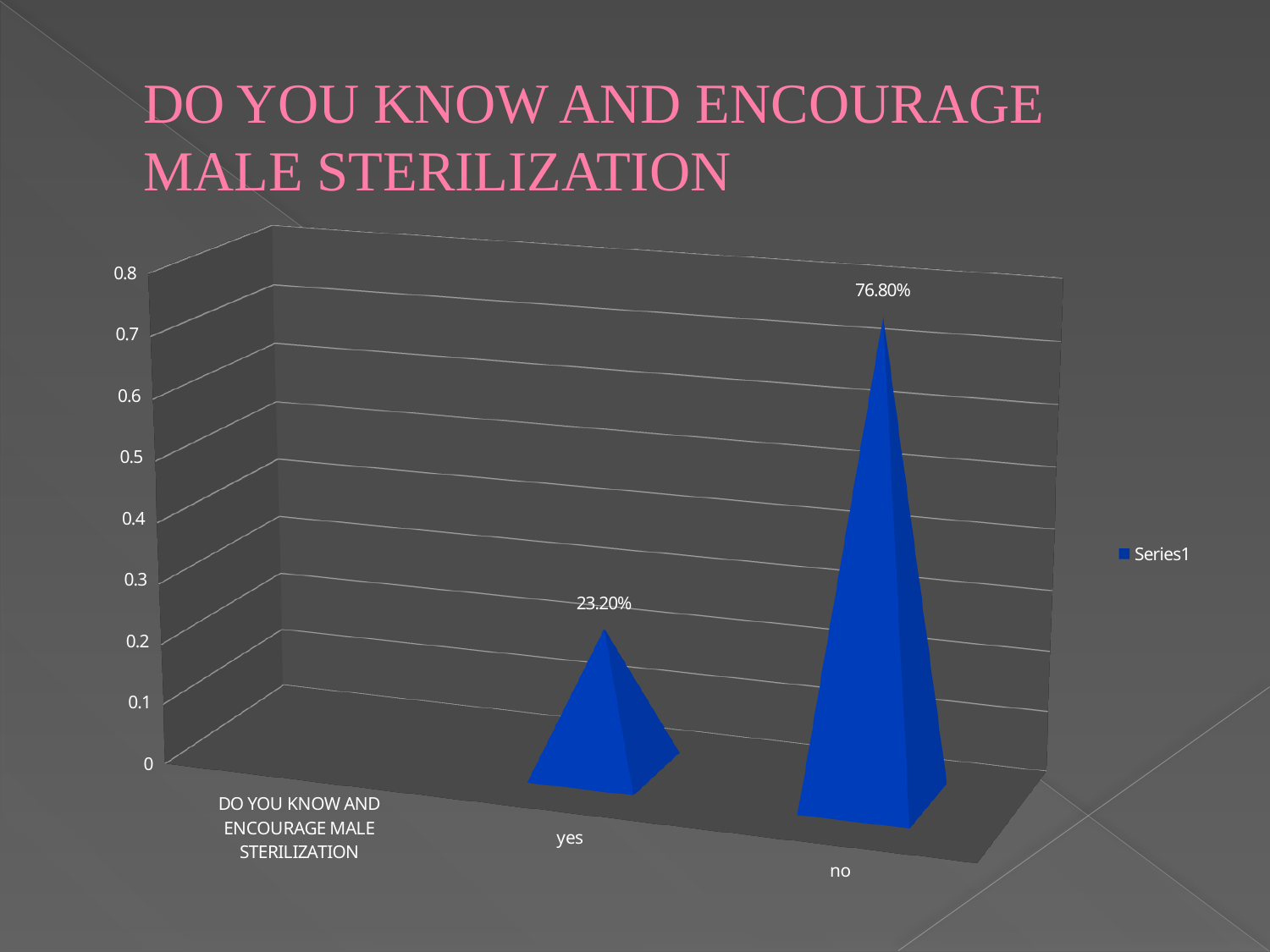
What is the value for "no"? 76.80% Which category has the highest value? no How many series does the legend list? 1 What is the difference between the values for "no" and "yes"? 53.60% What kind of chart is shown on the slide? bar chart Which category has the lowest value? yes Which is larger, the value for "yes" or the value for "no"? no Is the value for "no" greater or less than 0.7? greater What is the value for "yes"? 23.20% Is the value for "yes" greater or less than 0.3? less What is the name of the series shown in the legend? Series1 How many bars are plotted on the chart? 2